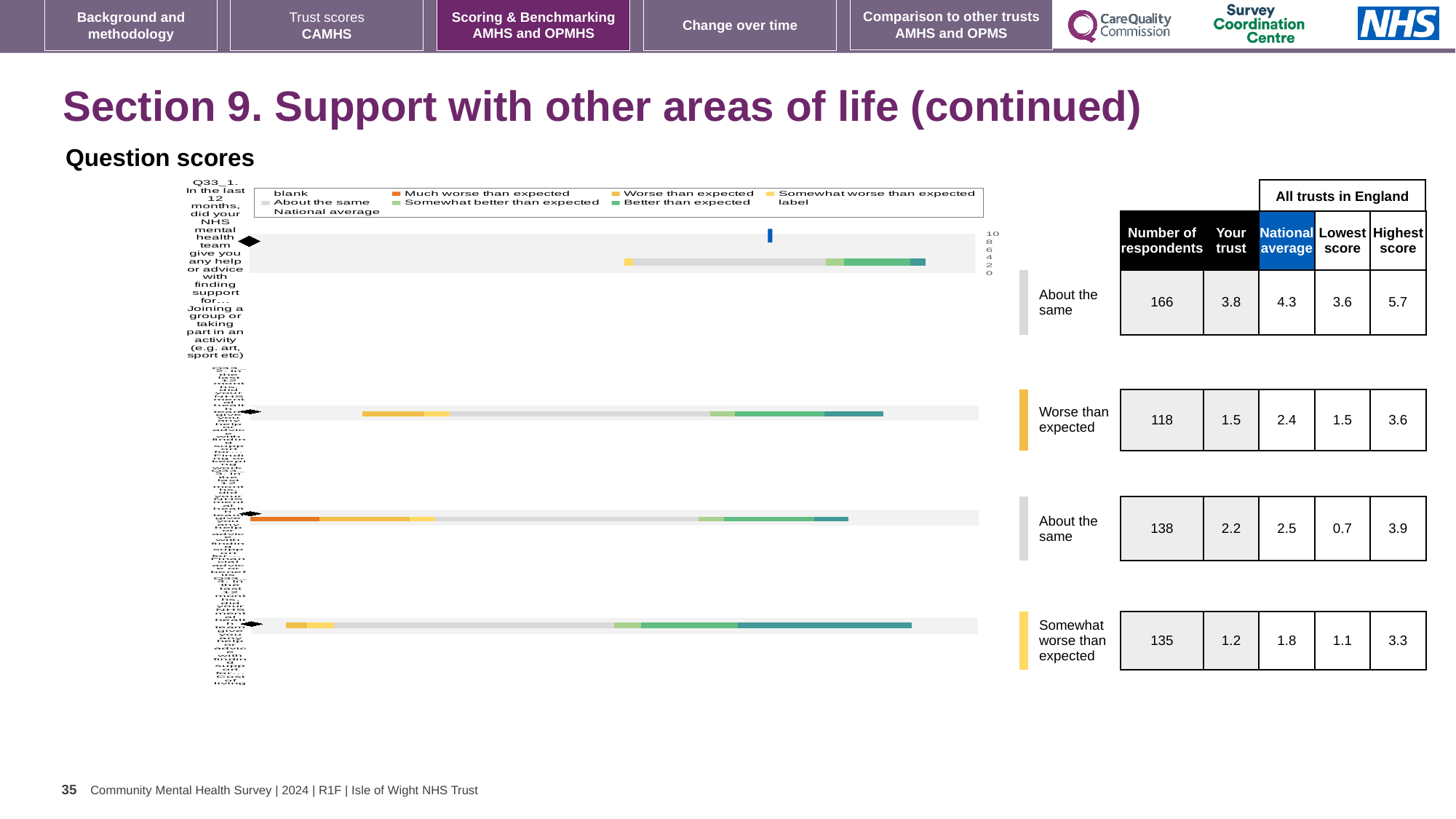
In the table to the right of the chart, which row has the smallest lowest score? About the same (138 respondents), 0.7 In the table to the right of the chart, what is the highest score for the row with 138 respondents? 3.9 Which legend entry of the 'Question scores' chart is shown in dark orange? Much worse than expected How many entries does the legend of the 'Question scores' chart list? 9 How many horizontal bars are plotted in the 'Question scores' chart? 4 In the table to the right of the chart, what is the national average for the row labelled 'Somewhat worse than expected'? 1.8 In the table to the right of the chart, for the top row (166 respondents), which is larger: the 'Your trust' score or the national average? National average In the table to the right of the chart, what is the number of respondents for the top row (labelled 'About the same')? 166 What is the first entry listed in the legend of the 'Question scores' chart? blank In the table to the right of the chart, what is the 'Your trust' score for the row labelled 'Worse than expected'? 1.5 In the table to the right of the chart, what is the difference between the national average and the 'Your trust' score for the row labelled 'Worse than expected'? 0.9 What kind of chart is shown under the heading 'Question scores'? bar chart